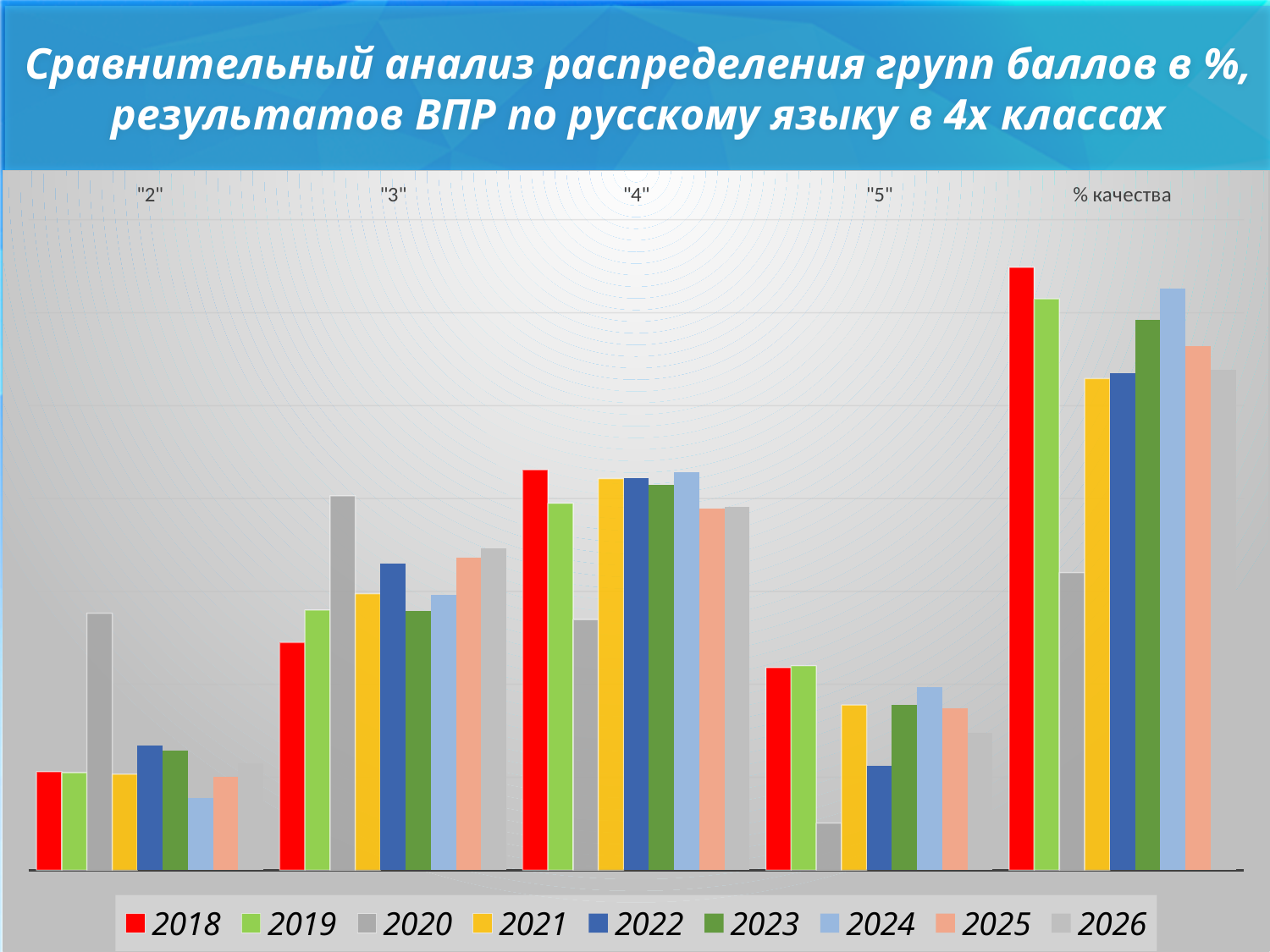
How many series does the legend list? 9 Which year has the lowest bar in the "% качества" category? 2020 Which colour represents the 2018 series in the legend? red Which year has the highest bar in the "% качества" category? 2018 How many categories are shown along the x axis? 5 Which year has the lowest bar in the "5" category? 2020 Which year has the lowest bar in the "2" category? 2024 Which year has the highest bar in the "3" category? 2020 What kind of chart is shown on the slide? bar chart In the "4" category, which is larger: the bar for 2018 or the bar for 2020? 2018 Which year has the highest bar in the "2" category? 2020 In the "% качества" category, which is larger: the bar for 2019 or the bar for 2025? 2019